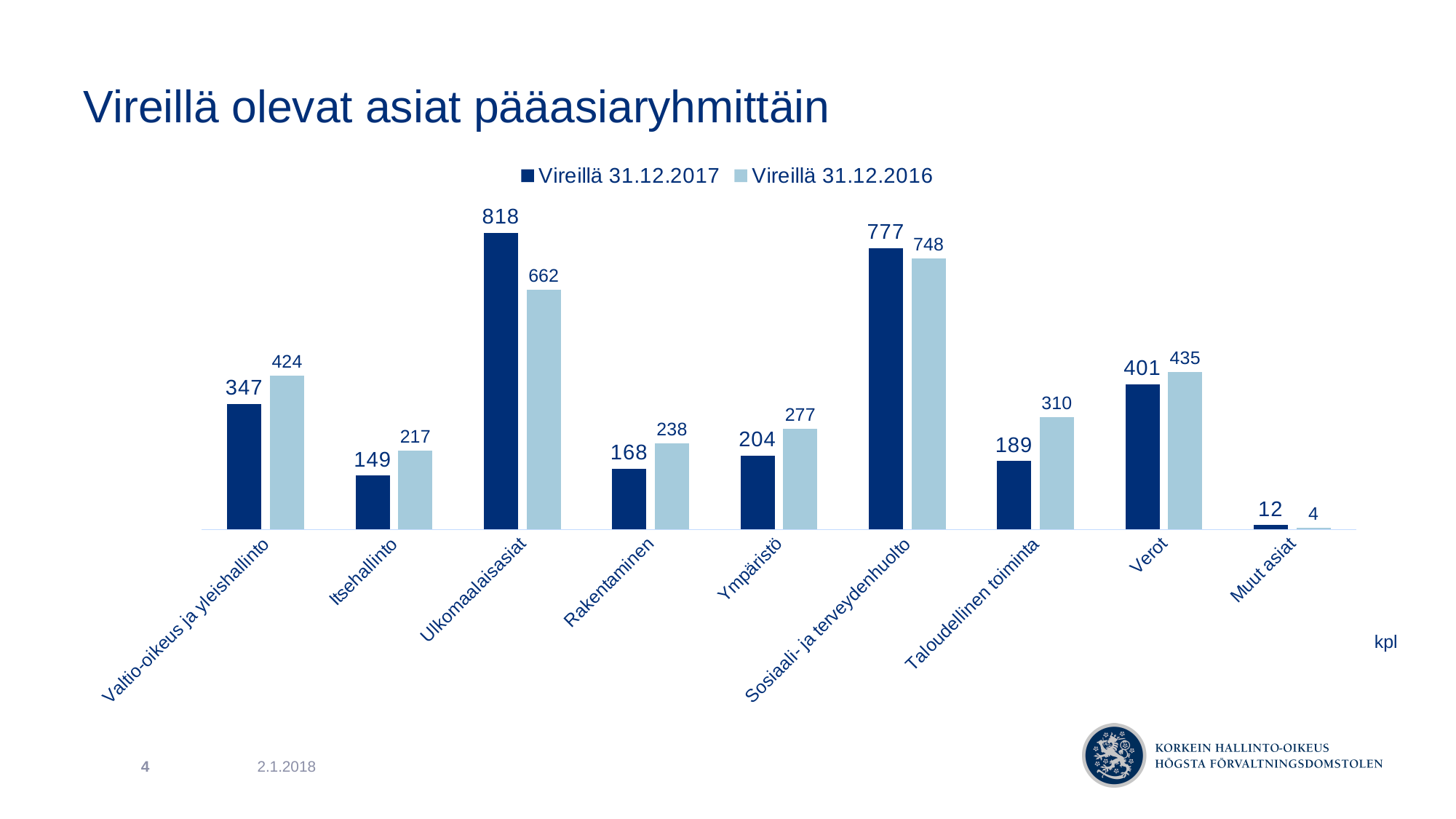
How many series does the legend list? 2 What is the difference between the Vireillä 31.12.2017 and Vireillä 31.12.2016 values for Ulkomaalaisasiat? 156 What is the difference between the Vireillä 31.12.2016 and Vireillä 31.12.2017 values for Taloudellinen toiminta? 121 Which category has the lowest value in the Vireillä 31.12.2017 series? Muut asiat How many categories are shown on the x axis? 9 What is the value for Verot in the Vireillä 31.12.2016 series? 435 Which category has the highest value in the Vireillä 31.12.2016 series? Sosiaali- ja terveydenhuolto What is the value for Ulkomaalaisasiat in the Vireillä 31.12.2017 series? 818 What is the value for Taloudellinen toiminta in the Vireillä 31.12.2017 series? 189 What is the title of the chart? Vireillä olevat asiat pääasiaryhmittäin What kind of chart is shown on the slide? Bar chart For Ympäristö, which series has the larger value: Vireillä 31.12.2017 or Vireillä 31.12.2016? Vireillä 31.12.2016